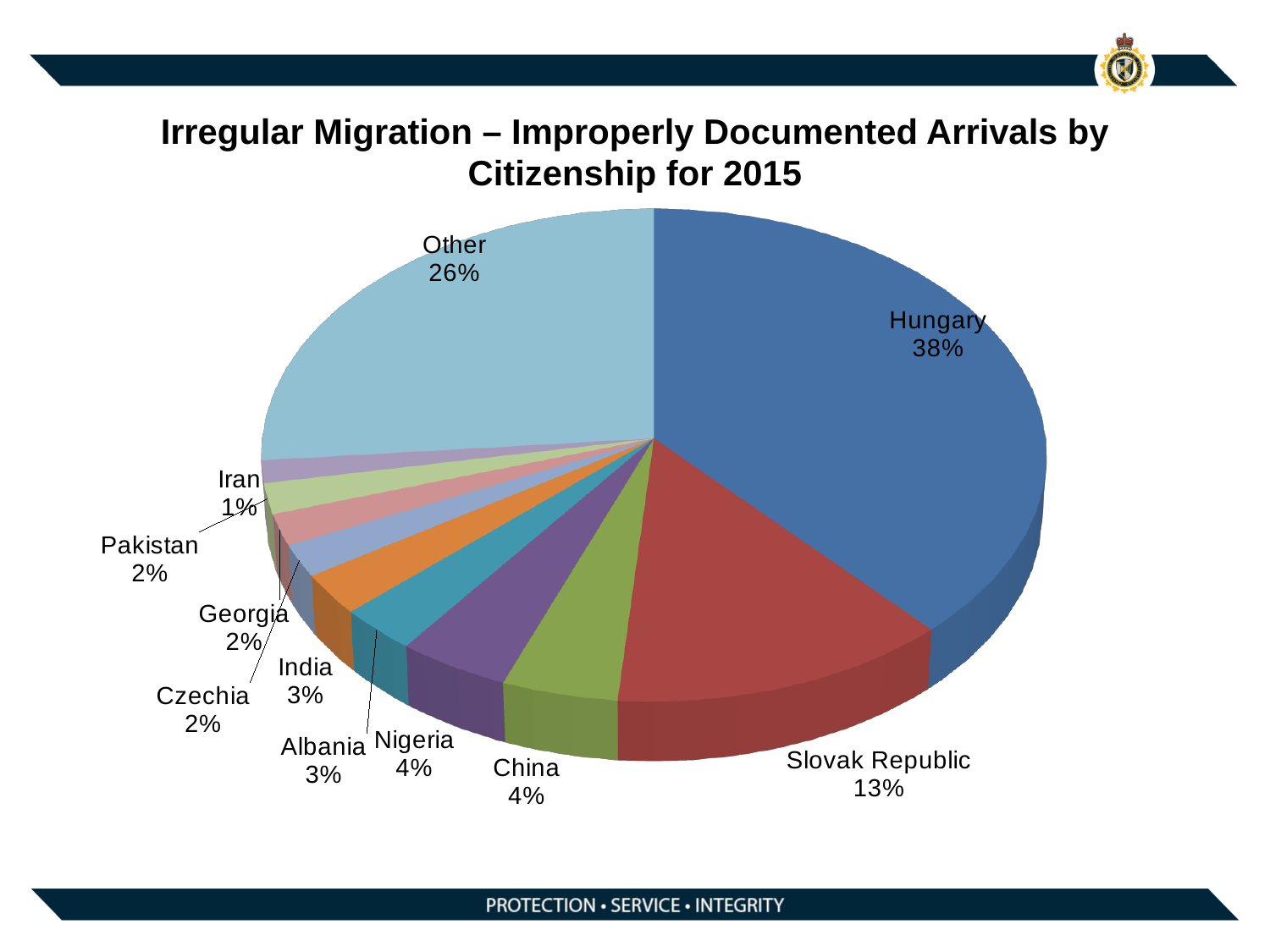
What percentage is shown for India? 3% What is the difference in percentage points between Hungary and Slovak Republic? 25 What is the title of the chart? Irregular Migration – Improperly Documented Arrivals by Citizenship for 2015 What percentage is shown for Nigeria? 4% What share does the Other slice represent? 26% How many slices does the pie chart have? 11 What percentage of the pie is labelled Slovak Republic? 13% Which citizenship has the largest share of the pie? Hungary Which has a larger share, China or Albania? China Which named citizenship has the smallest share of the pie? Iran What kind of chart is shown on the slide? Pie chart What share of improperly documented arrivals in 2015 is attributed to Hungary? 38%